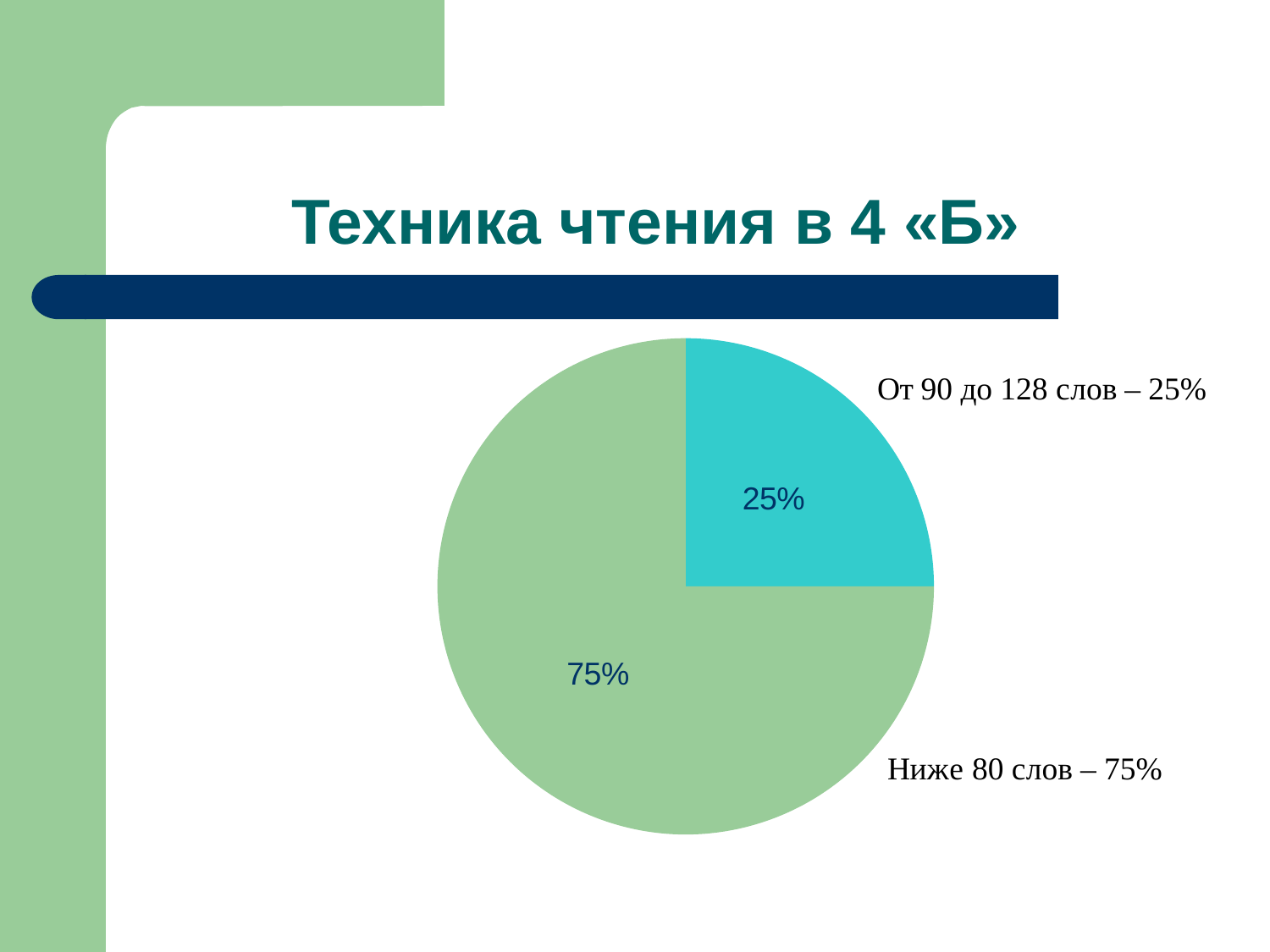
Which category has the smallest slice of the pie? От 90 до 128 слов What colour is the slice for "От 90 до 128 слов"? turquoise (cyan) What is the total of the two slice percentages shown on the pie chart? 100% Which slice is larger: "Ниже 80 слов" or "От 90 до 128 слов"? Ниже 80 слов What share of the pie is labelled "Ниже 80 слов"? 75% Which category has the largest slice of the pie? Ниже 80 слов How many slices does the pie chart have? 2 What is the difference in percentage points between the "Ниже 80 слов" slice and the "От 90 до 128 слов" slice? 50% What share of the pie is labelled "От 90 до 128 слов"? 25% What kind of chart is shown on the slide? pie chart What is the title of the slide containing the pie chart? Техника чтения в 4 «Б»